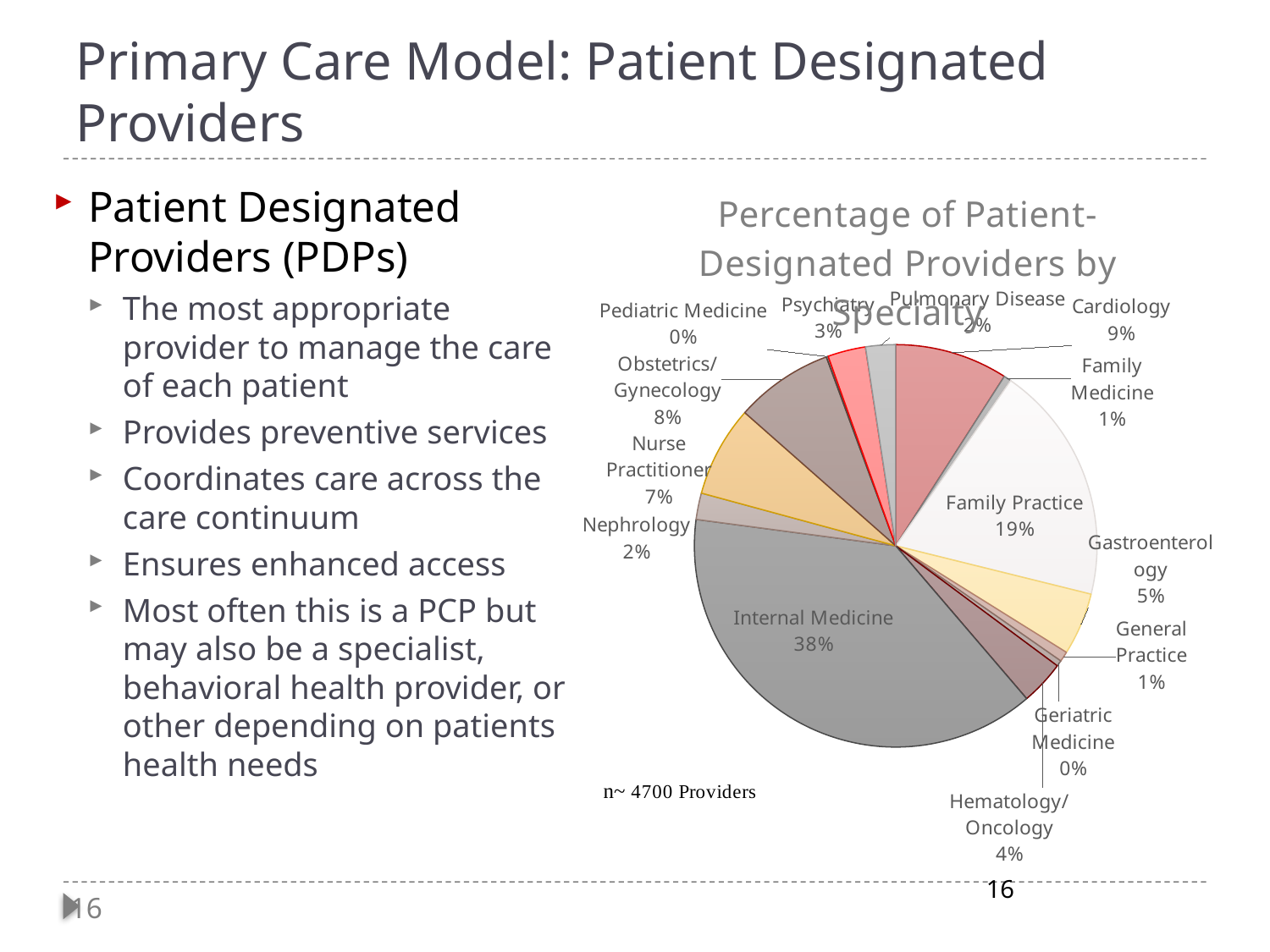
Which has a larger share, Obstetrics/Gynecology or Gastroenterology? Obstetrics/Gynecology What percentage of patient-designated providers are in Internal Medicine? 38% What is the difference in percentage points between Internal Medicine and Family Practice? 19 What percentage of patient-designated providers are in Family Practice? 19% What percentage of patient-designated providers are Nurse Practitioners? 7% How many specialty categories are shown in the pie chart? 14 Which specialty has the largest share of patient-designated providers? Internal Medicine What percentage of patient-designated providers are in Cardiology? 9% What kind of chart is shown on the slide? pie chart What is the title of the chart? Percentage of Patient-Designated Providers by Specialty Approximately how many providers does the chart note as its sample size? n~ 4700 Providers What percentage of patient-designated providers are in Hematology/Oncology? 4%